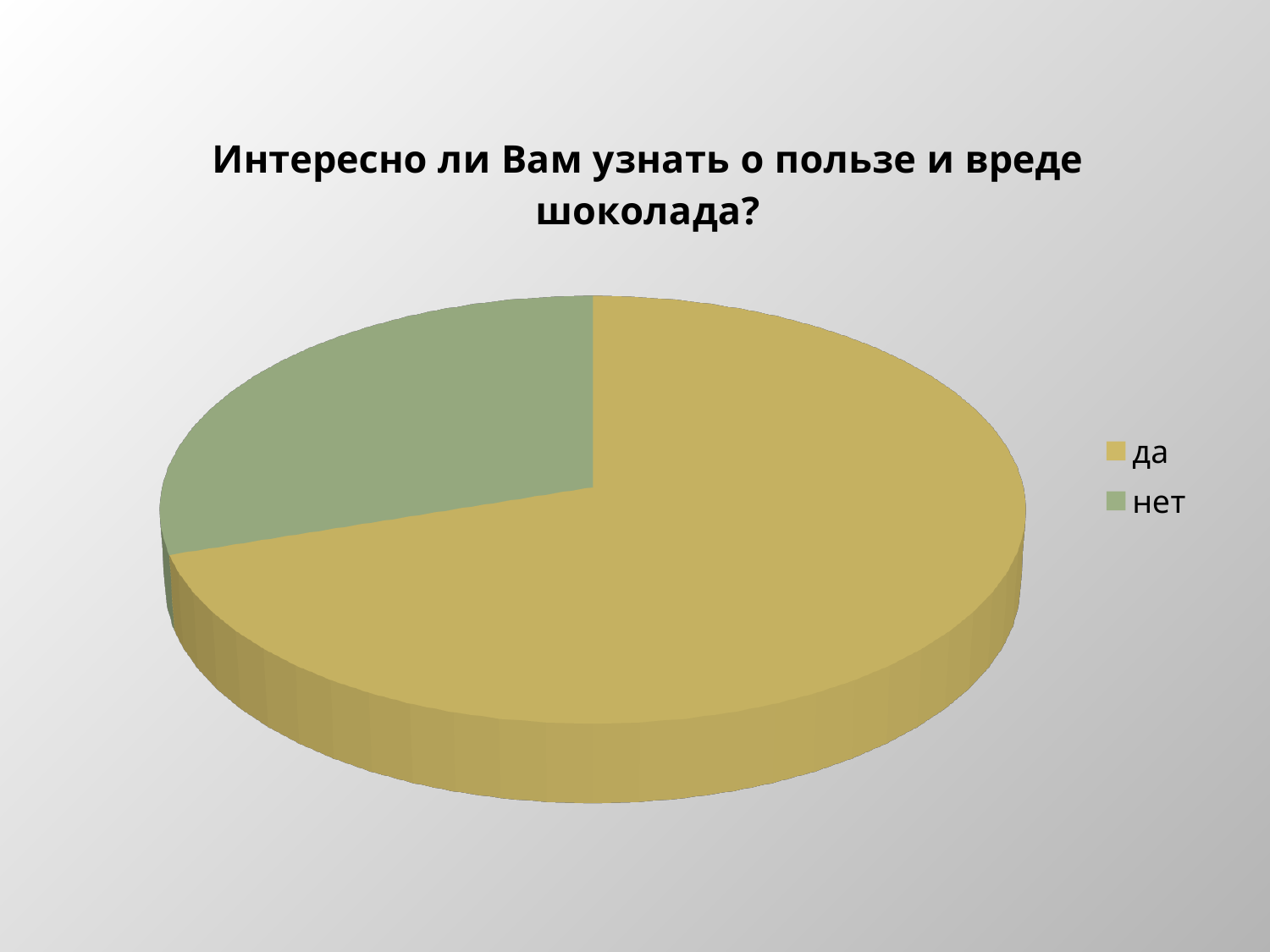
What kind of chart is shown on the slide? pie chart Which slice is the smallest in the pie chart? нет Which slice is the largest in the pie chart? да How many slices does the pie chart have? 2 What is the title of the chart? Интересно ли Вам узнать о пользе и вреде шоколада? Which slice is larger, "да" or "нет"? да What colour is the "нет" slice? green How many entries does the legend list? 2